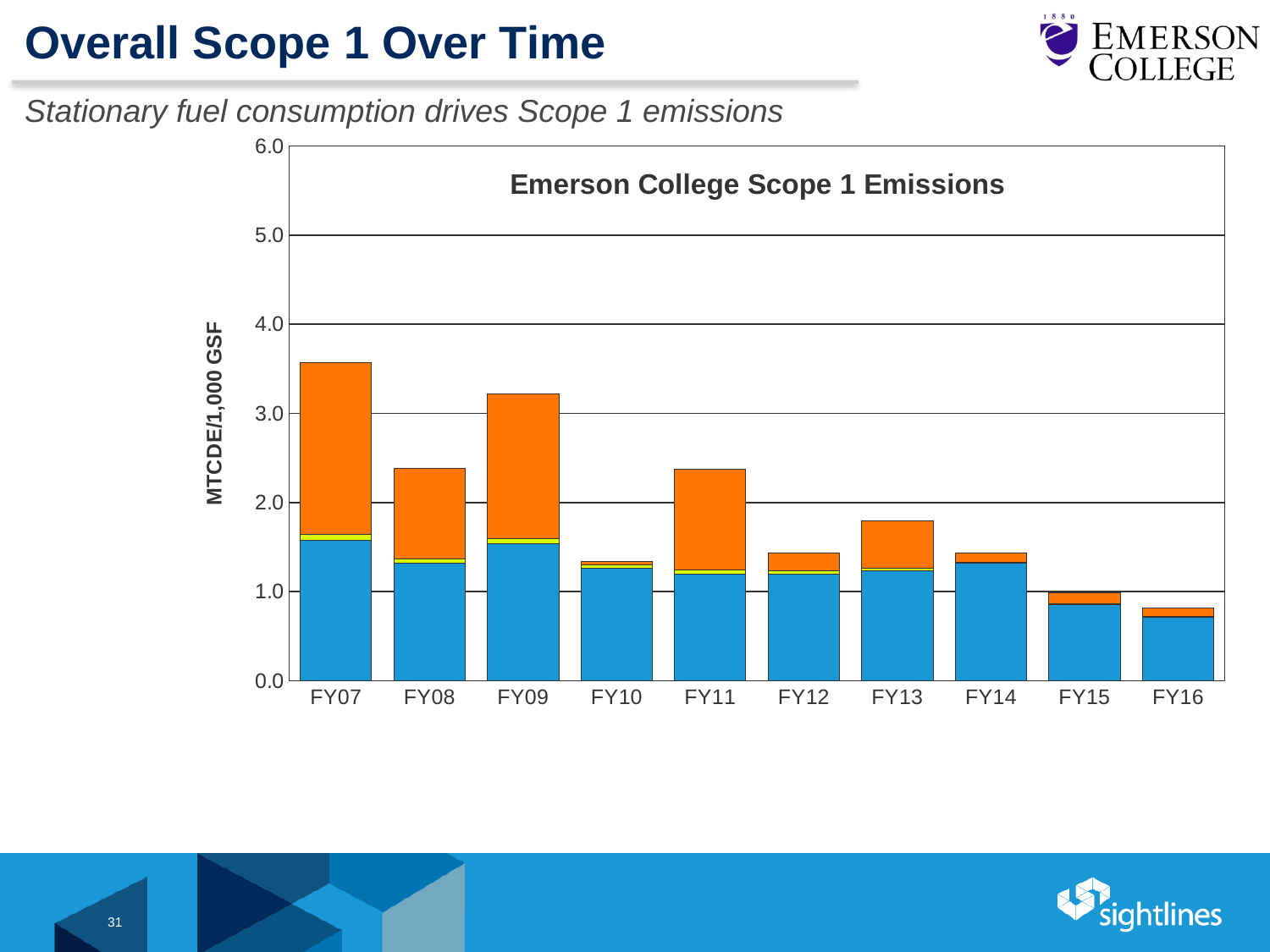
Overall, do the total bars rise or fall from FY07 to FY16? Fall Which fiscal year has the lowest total bar in the chart? FY16 Is the total value for FY10 greater or less than 2.0? less What kind of chart is shown on the slide? Stacked bar chart Which fiscal year has the highest total bar in the chart? FY07 Which has the larger total bar, FY09 or FY08? FY09 Which has the larger total bar, FY13 or FY14? FY13 Is the total value for FY11 greater or less than 2.0? greater Is the total value for FY07 greater or less than 3.0? greater How many fiscal years are shown on the x axis of the chart? 10 What is the title of the chart? Emerson College Scope 1 Emissions